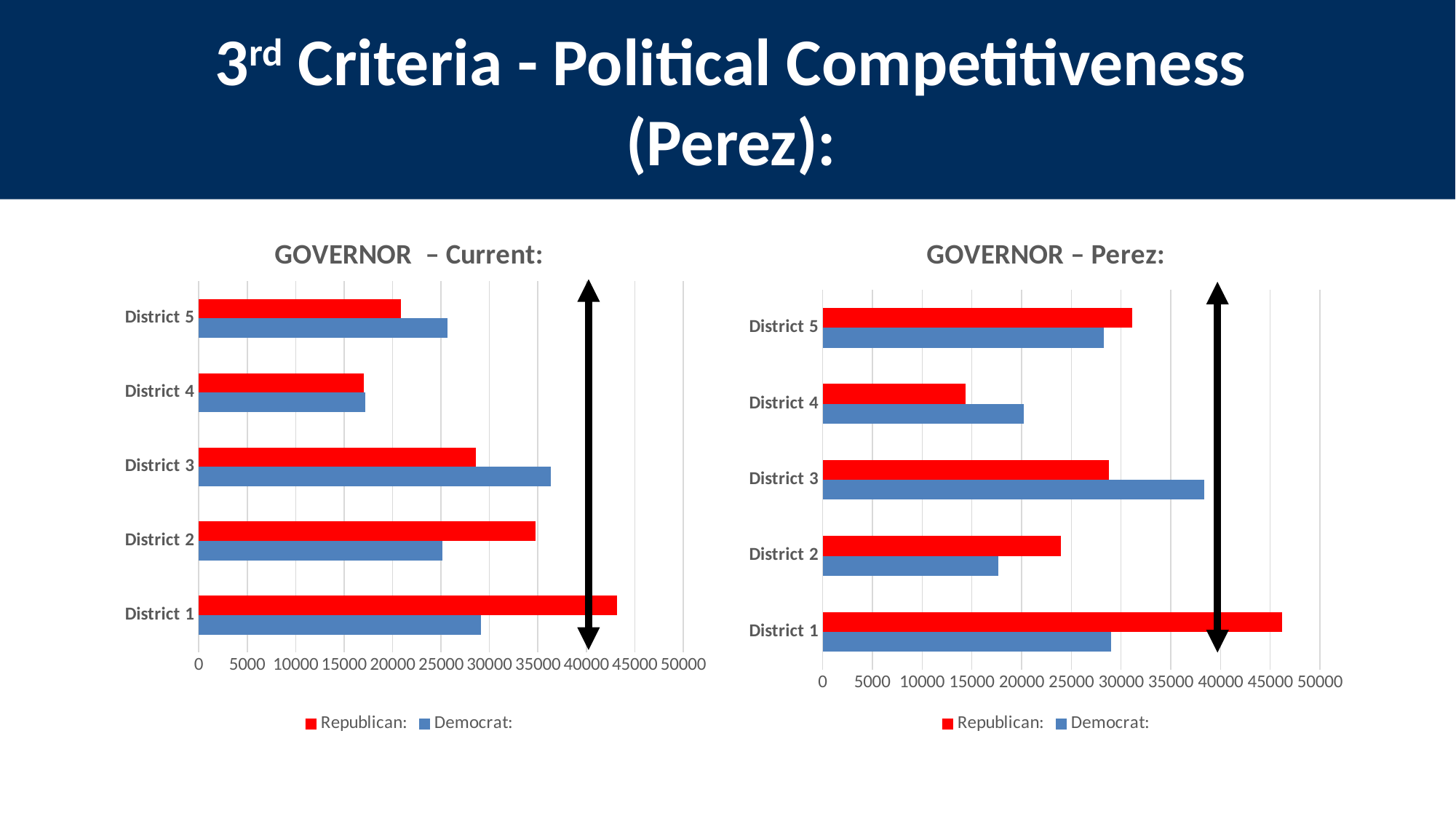
On the GOVERNOR – Perez chart, is the Democrat value for District 3 greater or less than 35000? greater On the GOVERNOR – Current chart, is the Republican value for District 1 greater or less than 40000? greater What colour represents the Democrat series on the charts? blue On the GOVERNOR – Current chart, is the Democrat value for District 4 greater or less than 20000? less How many districts are shown on the GOVERNOR – Perez chart? 5 How many series does the legend of the GOVERNOR – Current chart list? 2 On the GOVERNOR – Perez chart, which district has the highest Democrat value? District 3 On the GOVERNOR – Current chart, which district has the highest Republican value? District 1 What kind of chart is the GOVERNOR – Current chart? bar chart On the GOVERNOR – Current chart, which is larger for District 3, the Republican value or the Democrat value? Democrat On the GOVERNOR – Perez chart, which district has the lowest Republican value? District 4 On the GOVERNOR – Perez chart, which is larger for District 2, the Republican value or the Democrat value? Republican